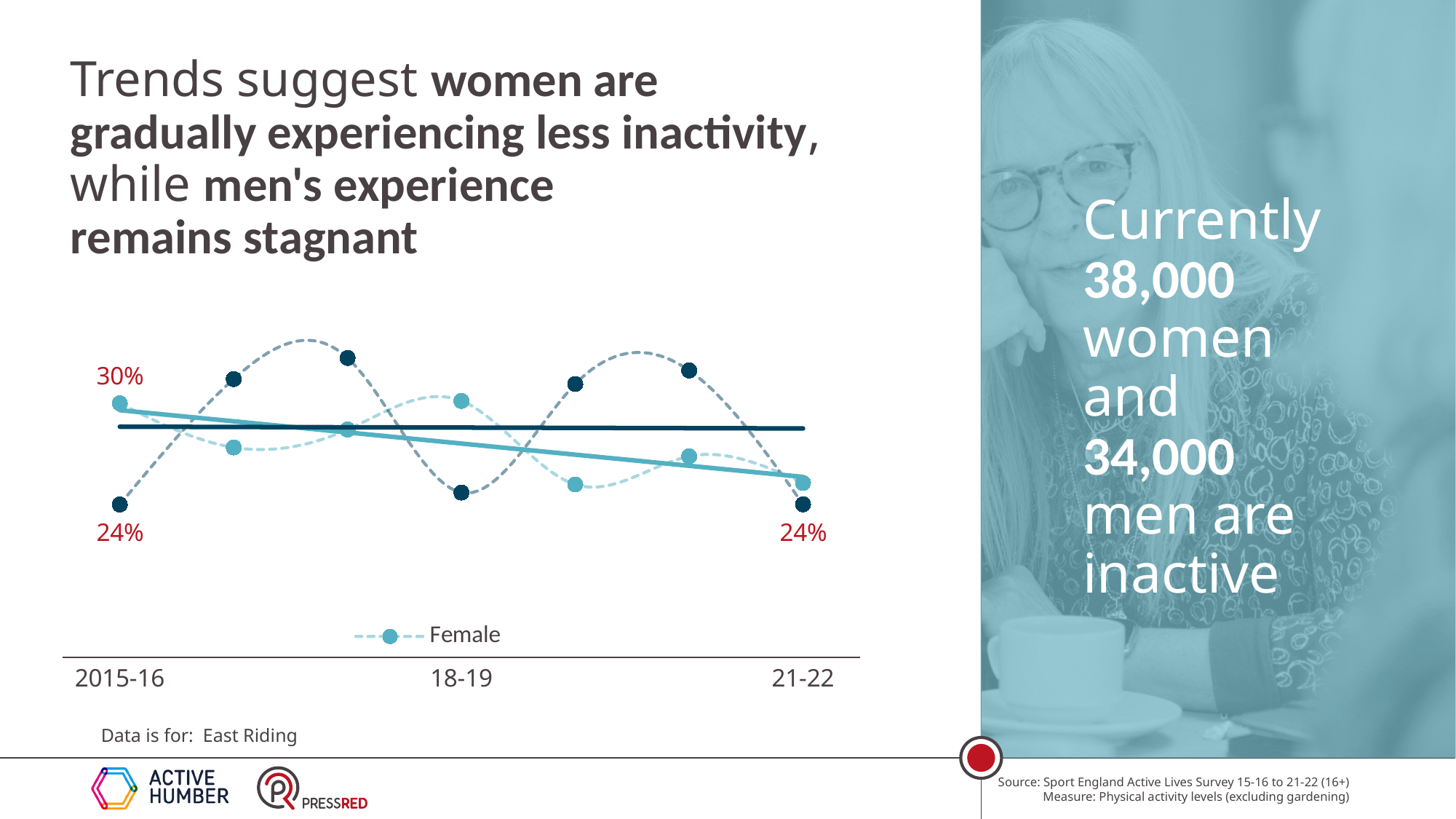
At 2015-16, is the Female value higher or lower than the other series' value? higher What is the Female value labelled at 2015-16? 30% What is the first label on the x axis? 2015-16 What is the difference between the two labelled values at 2015-16 (30% and 24%)? 6 percentage points What is the value labelled at 21-22? 24% What kind of chart is shown on the slide? line chart What is the value labelled at the lowest point in 2015-16? 24% How many data points does the Female series have? 7 Which series name is shown in the chart legend? Female Does the Female trend line rise or fall from 2015-16 to 21-22? fall